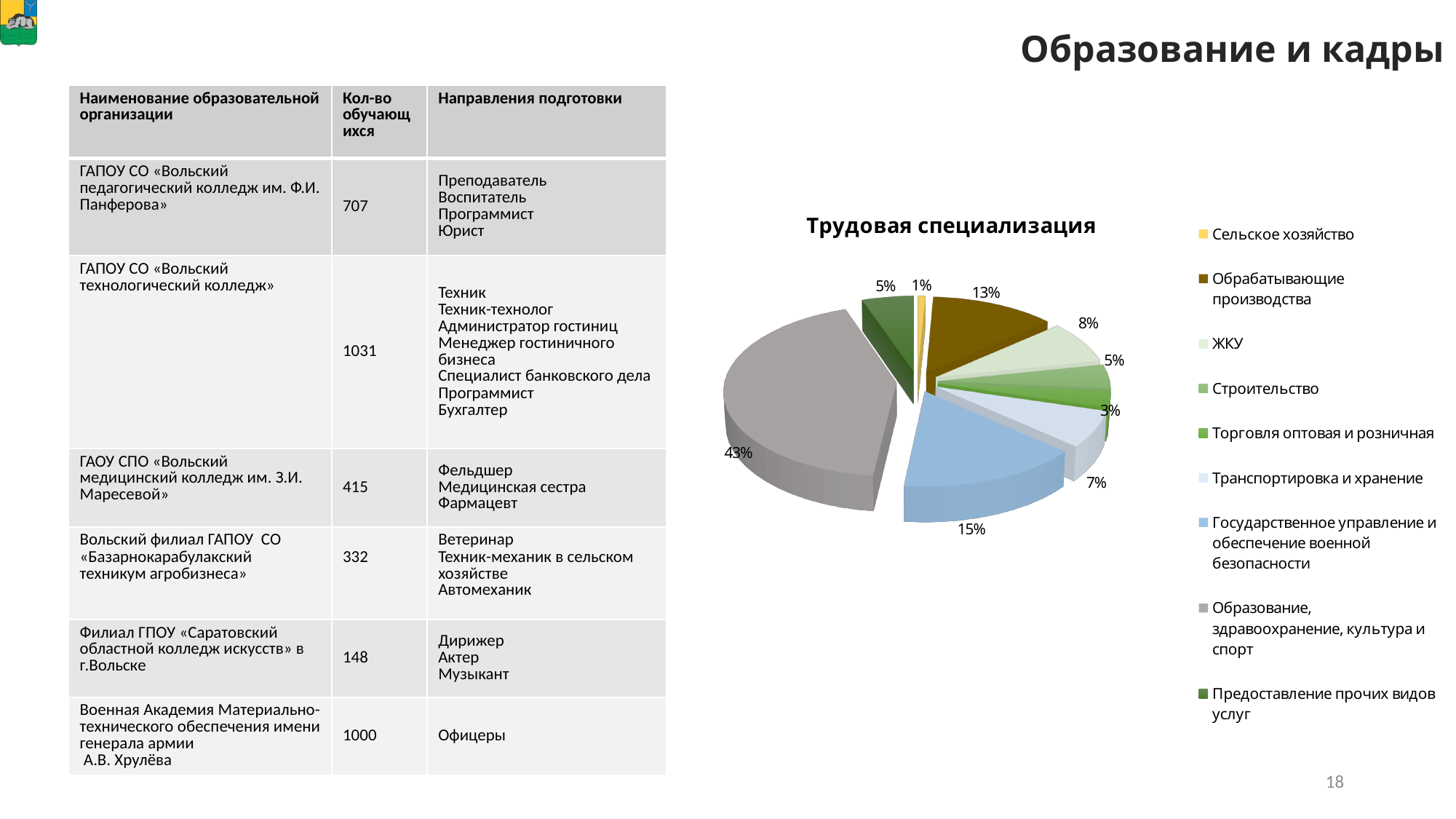
In the pie chart "Трудовая специализация", what share is shown for "Образование, здравоохранение, культура и спорт"? 43% What kind of chart is shown under the title "Трудовая специализация"? pie chart In the pie chart "Трудовая специализация", which category has the largest share? Образование, здравоохранение, культура и спорт In the pie chart "Трудовая специализация", what is the difference between the shares of "Государственное управление и обеспечение военной безопасности" and "Обрабатывающие производства"? 2% In the pie chart "Трудовая специализация", what share is shown for "ЖКУ"? 8% In the pie chart "Трудовая специализация", what share is shown for "Сельское хозяйство"? 1% What is the title of the pie chart on the slide? Трудовая специализация In the pie chart "Трудовая специализация", what share is shown for "Обрабатывающие производства"? 13% In the pie chart "Трудовая специализация", which category has the smallest share? Сельское хозяйство In the pie chart "Трудовая специализация", what share is shown for "Государственное управление и обеспечение военной безопасности"? 15% In the pie chart "Трудовая специализация", which is larger: the share of "ЖКУ" or the share of "Транспортировка и хранение"? ЖКУ How many categories does the legend of the pie chart "Трудовая специализация" list? 9